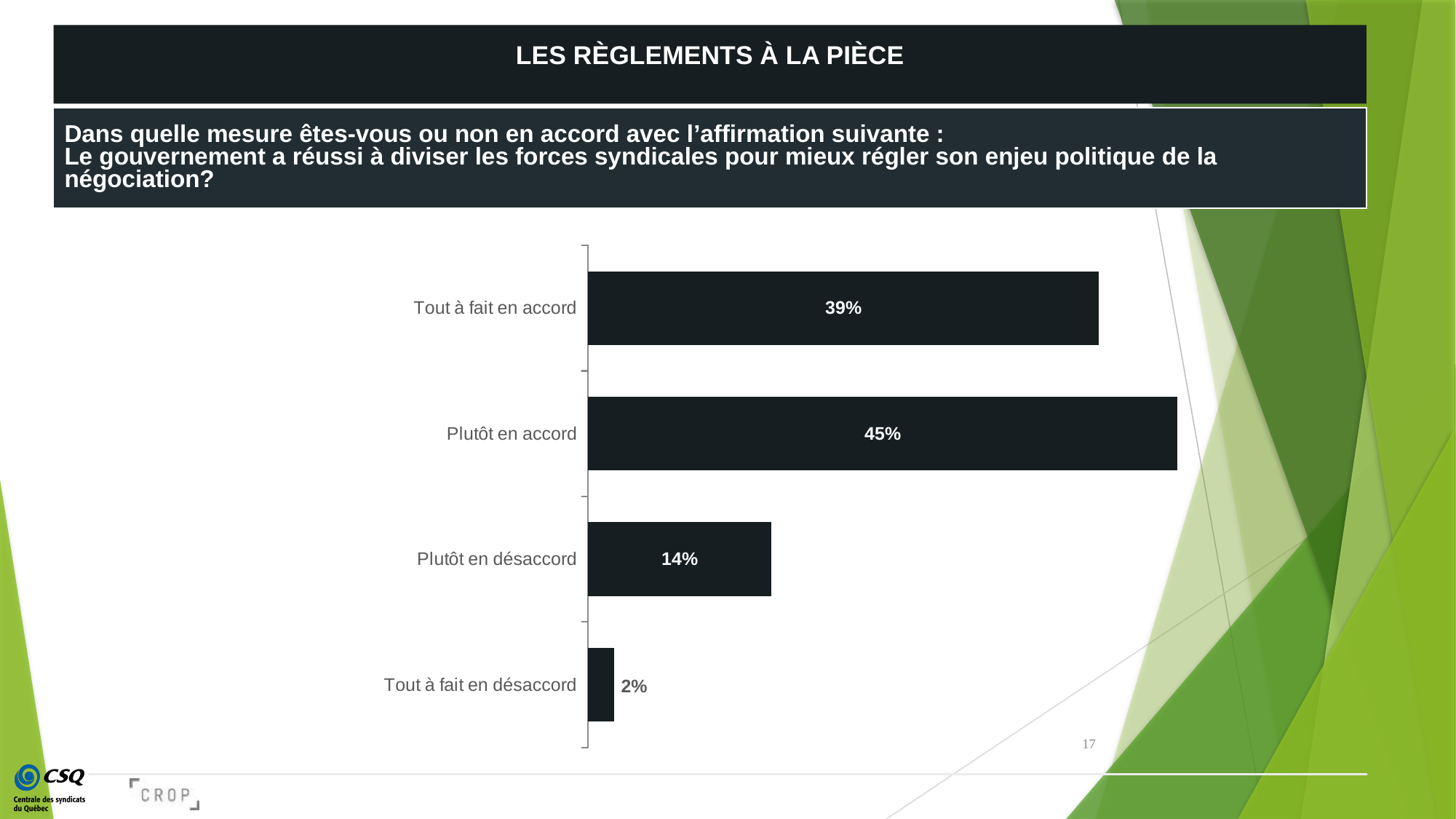
What is the title shown at the top of the slide? LES RÈGLEMENTS À LA PIÈCE What is the value for "Tout à fait en désaccord"? 2% Which category has the highest value? Plutôt en accord What kind of chart is shown on the slide? Bar chart What is the value for "Plutôt en désaccord"? 14% What is the value for "Tout à fait en accord"? 39% What is the difference between the values for "Plutôt en désaccord" and "Tout à fait en désaccord"? 12% What is the difference between the values for "Plutôt en accord" and "Tout à fait en accord"? 6% Which is larger, the value for "Tout à fait en accord" or the value for "Plutôt en désaccord"? Tout à fait en accord How many categories are shown in the chart? 4 What is the value for "Plutôt en accord"? 45% Which category has the lowest value? Tout à fait en désaccord